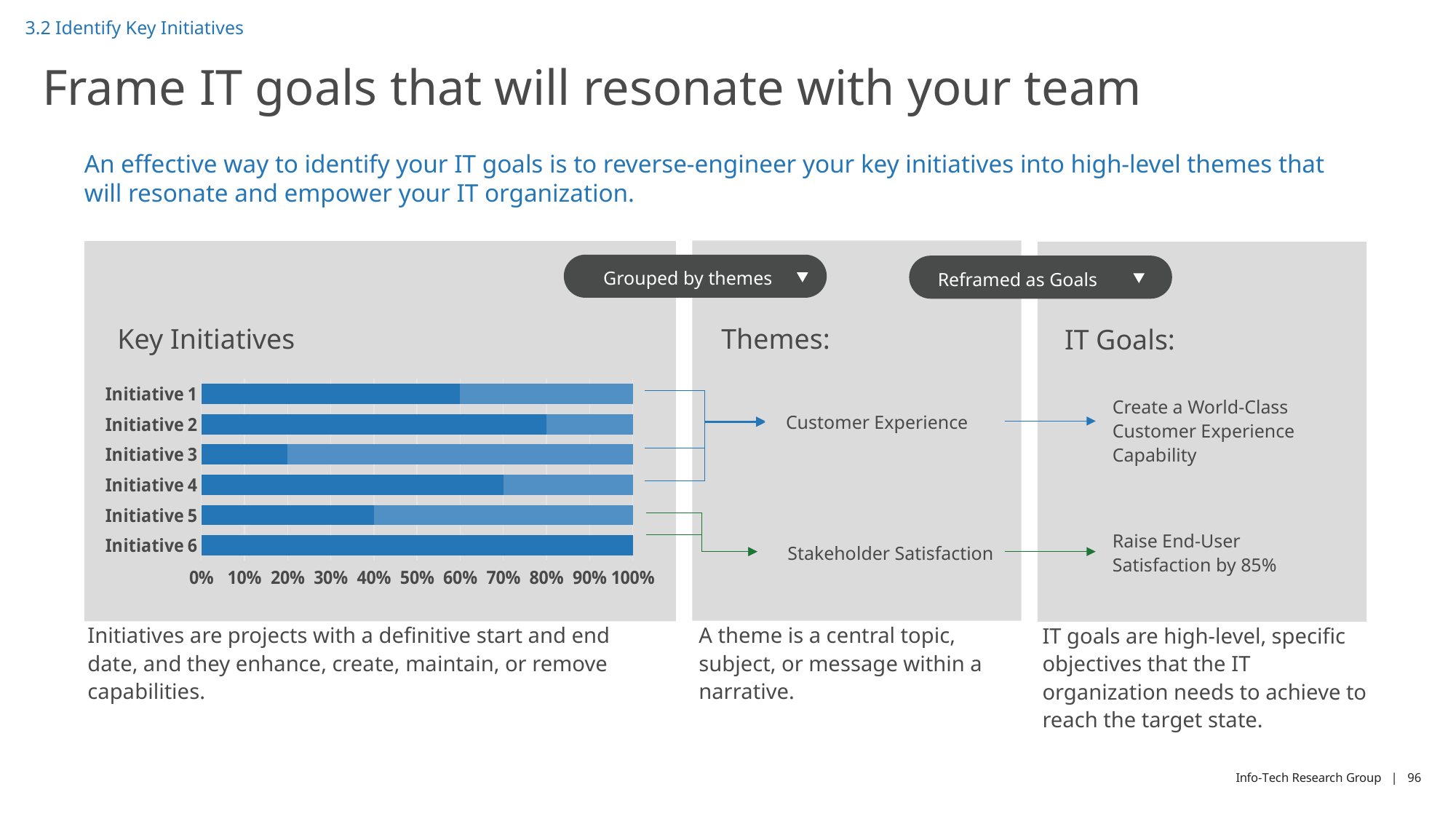
What kind of chart is shown under the heading "Key Initiatives"? Bar chart Is the dark blue segment for Initiative 6 greater or less than 90%? greater What is the highest value shown on the x axis of the Key Initiatives chart? 100% Which initiative has the longest dark blue segment in the Key Initiatives chart? Initiative 6 Is the dark blue segment for Initiative 2 greater or less than 70%? greater Which initiative has the shortest dark blue segment in the Key Initiatives chart? Initiative 3 Which has the longer dark blue segment, Initiative 1 or Initiative 3? Initiative 1 Is the dark blue segment for Initiative 3 greater or less than 30%? less How many initiatives are plotted in the Key Initiatives chart? 6 What is the heading above the bar chart on the left panel? Key Initiatives Which has the longer dark blue segment, Initiative 4 or Initiative 5? Initiative 4